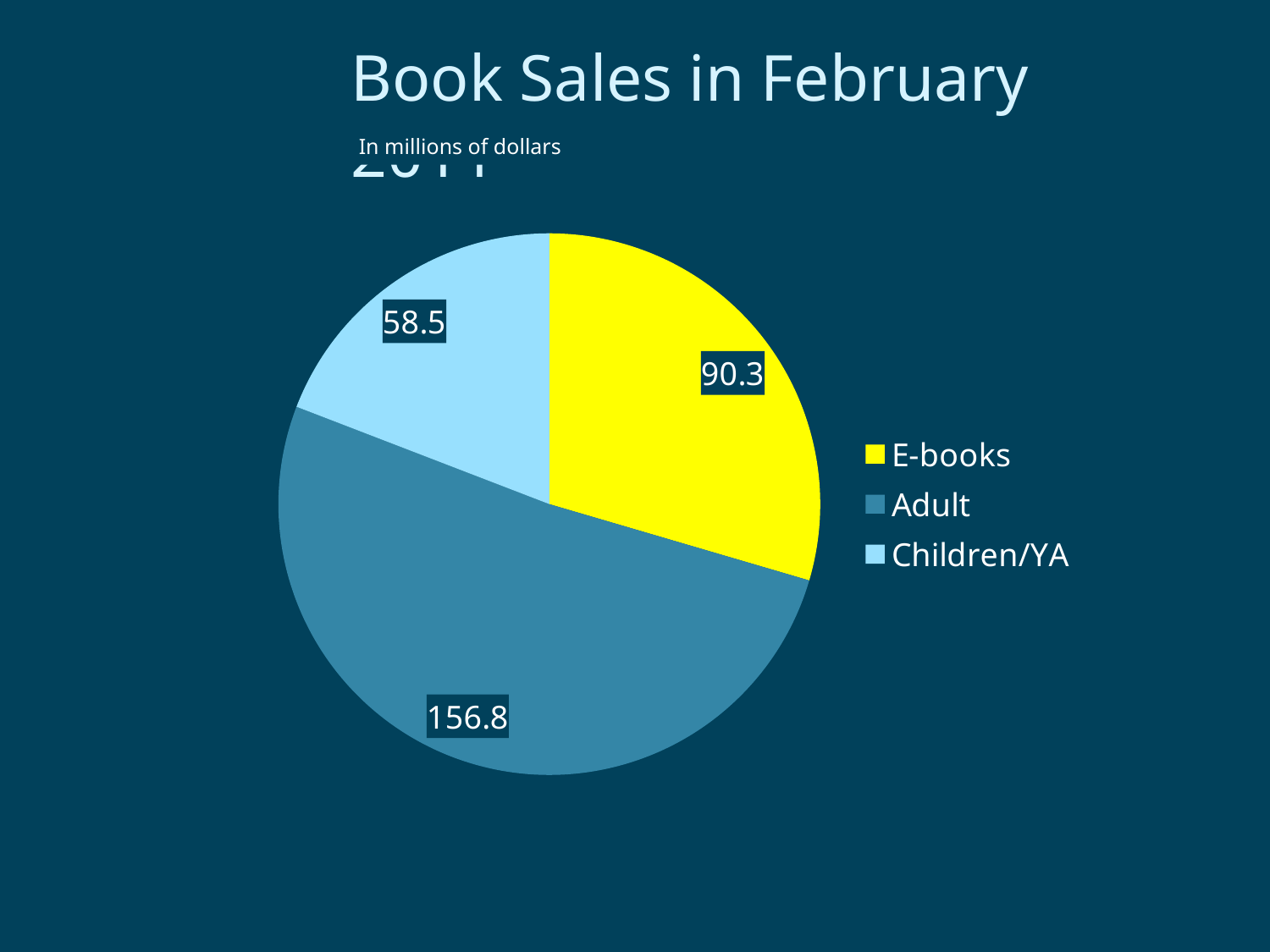
What is the value for Adult in the pie chart? 156.8 Which category has the largest slice of the pie? Adult What kind of chart is shown on the slide? Pie chart What is the difference between the Adult and E-books values? 66.5 What share of the pie does the Adult slice represent, to one decimal place? 51.3% Which is larger, the value for E-books or the value for Children/YA? E-books Which category has the smallest slice of the pie? Children/YA How many categories does the pie chart show? 3 What is the title of the chart? Book Sales in February What is the value for Children/YA in the pie chart? 58.5 What is the difference between the E-books and Children/YA values? 31.8 What is the value for E-books in the pie chart? 90.3